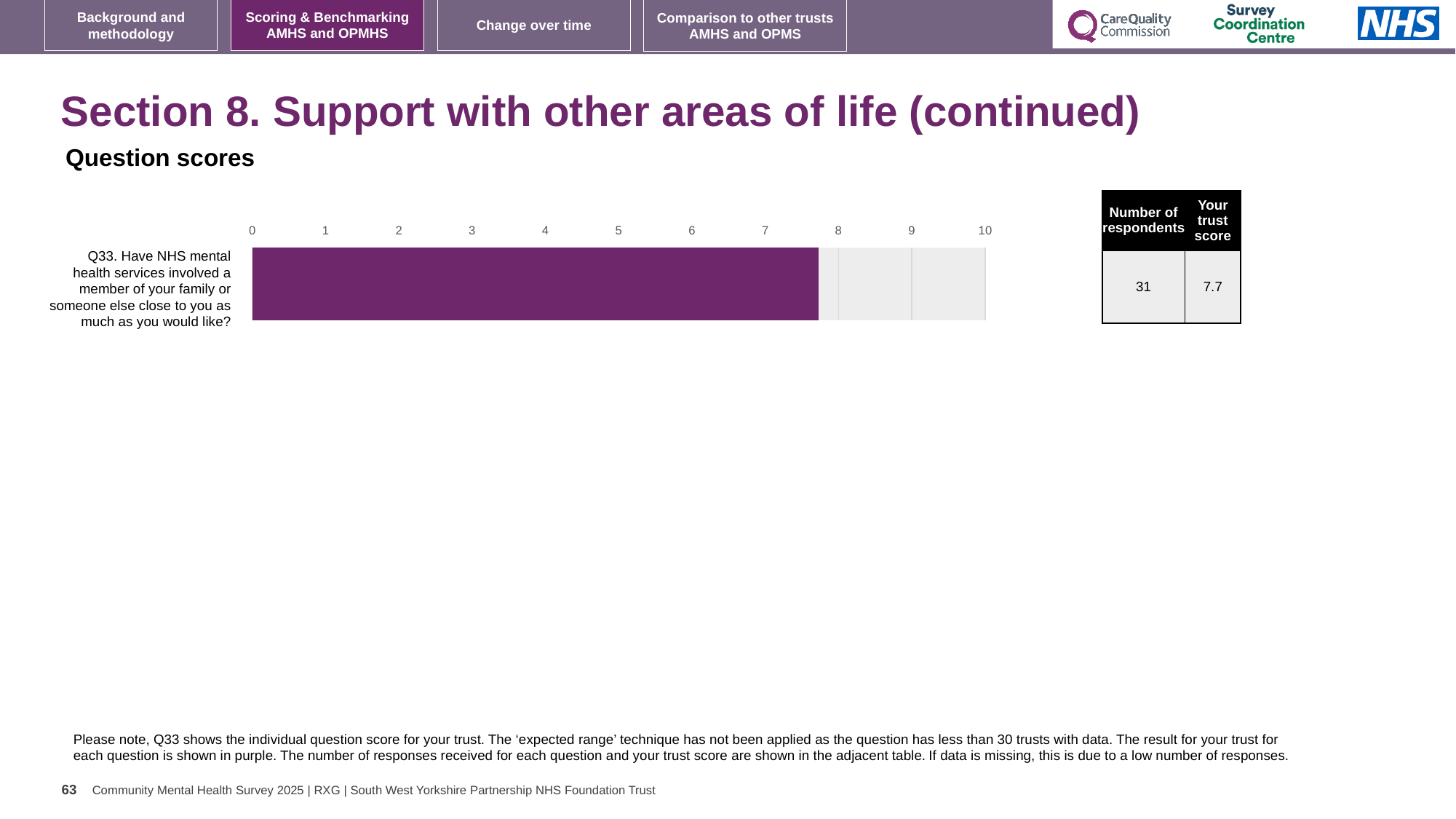
What is the maximum value shown on the chart's horizontal axis? 10 What colour is the bar representing the trust's result for Q33? purple What is the trust score for Q33 shown in the adjacent table? 7.7 How many respondents answered Q33 according to the table? 31 What kind of chart is shown on the slide? bar chart Is the value of the bar for Q33 greater or less than 7? greater How many questions (categories) are plotted in the chart? 1 Is the value of the bar for Q33 greater or less than 8? less Is the value of the bar for Q33 greater or less than 5? greater